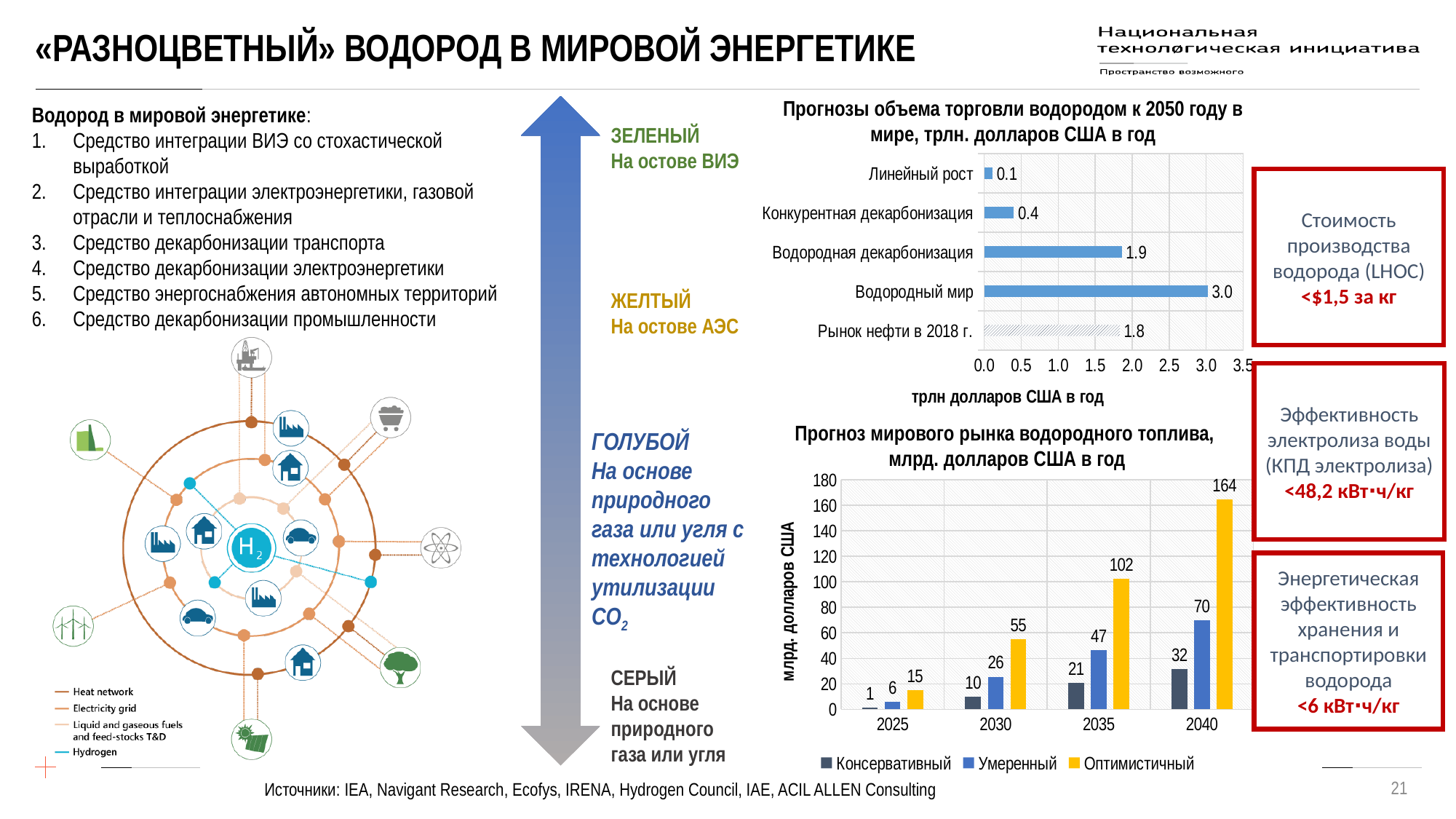
In the chart 'Прогнозы объема торговли водородом к 2050 году в мире', how many categories are shown? 5 In the chart 'Прогноз мирового рынка водородного топлива', what is the value of the 'Консервативный' series for 2035? 21 In the chart 'Прогнозы объема торговли водородом к 2050 году в мире', which category has the lowest value? Линейный рост What type of chart is 'Прогнозы объема торговли водородом к 2050 году в мире'? Bar chart In the chart 'Прогнозы объема торговли водородом к 2050 году в мире', what is the value for 'Водородный мир'? 3.0 In the chart 'Прогноз мирового рынка водородного топлива', do the 'Умеренный' values rise or fall from 2025 to 2040? Rise In the chart 'Прогнозы объема торговли водородом к 2050 году в мире', what is the difference between 'Водородная декарбонизация' and 'Конкурентная декарбонизация'? 1.5 In the chart 'Прогноз мирового рынка водородного топлива', what is the difference between the 'Оптимистичный' and 'Умеренный' values for 2030? 29 In the chart 'Прогноз мирового рынка водородного топлива', what is the value of the 'Оптимистичный' series for 2040? 164 In the chart 'Прогноз мирового рынка водородного топлива', how many series does the legend list? 3 In the chart 'Прогнозы объема торговли водородом к 2050 году в мире', what is the value for 'Рынок нефти в 2018 г.'? 1.8 In the chart 'Прогноз мирового рынка водородного топлива', which is larger: 'Умеренный' for 2040 or 'Оптимистичный' for 2030? Умеренный for 2040